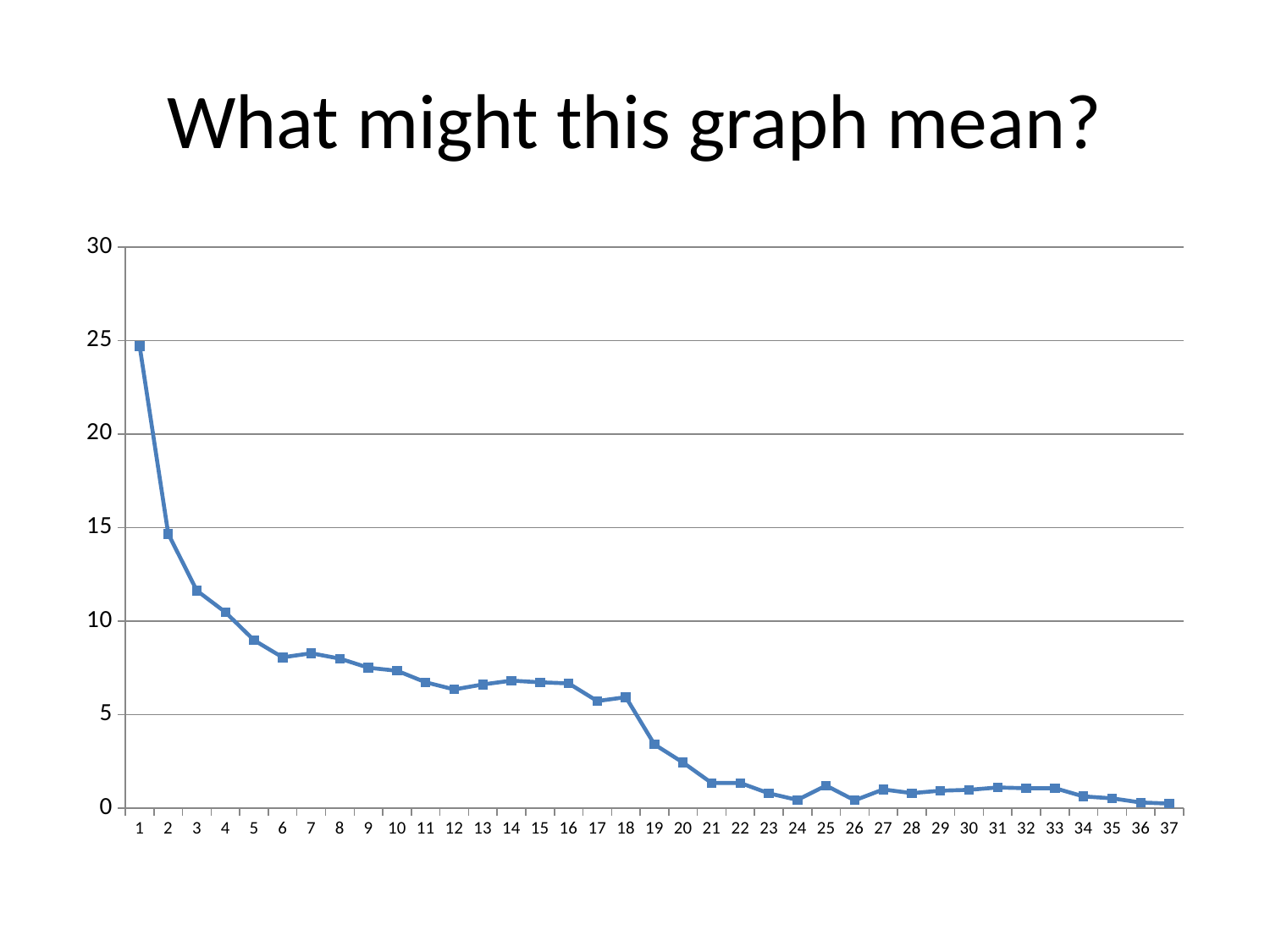
Is the value at category 19 greater or less than 5? less Is the value at category 3 greater or less than 10? greater What is the title of the slide above the chart? What might this graph mean? Is the value at category 12 greater or less than 5? greater Overall, do the values rise or fall as you move from left to right along the x axis? fall Which has the larger value, category 5 or category 10? 5 Which has the larger value, category 18 or category 20? 18 Which x-axis category has the highest value? 1 What kind of chart is shown on the slide? line chart How many data points are plotted on the line? 37